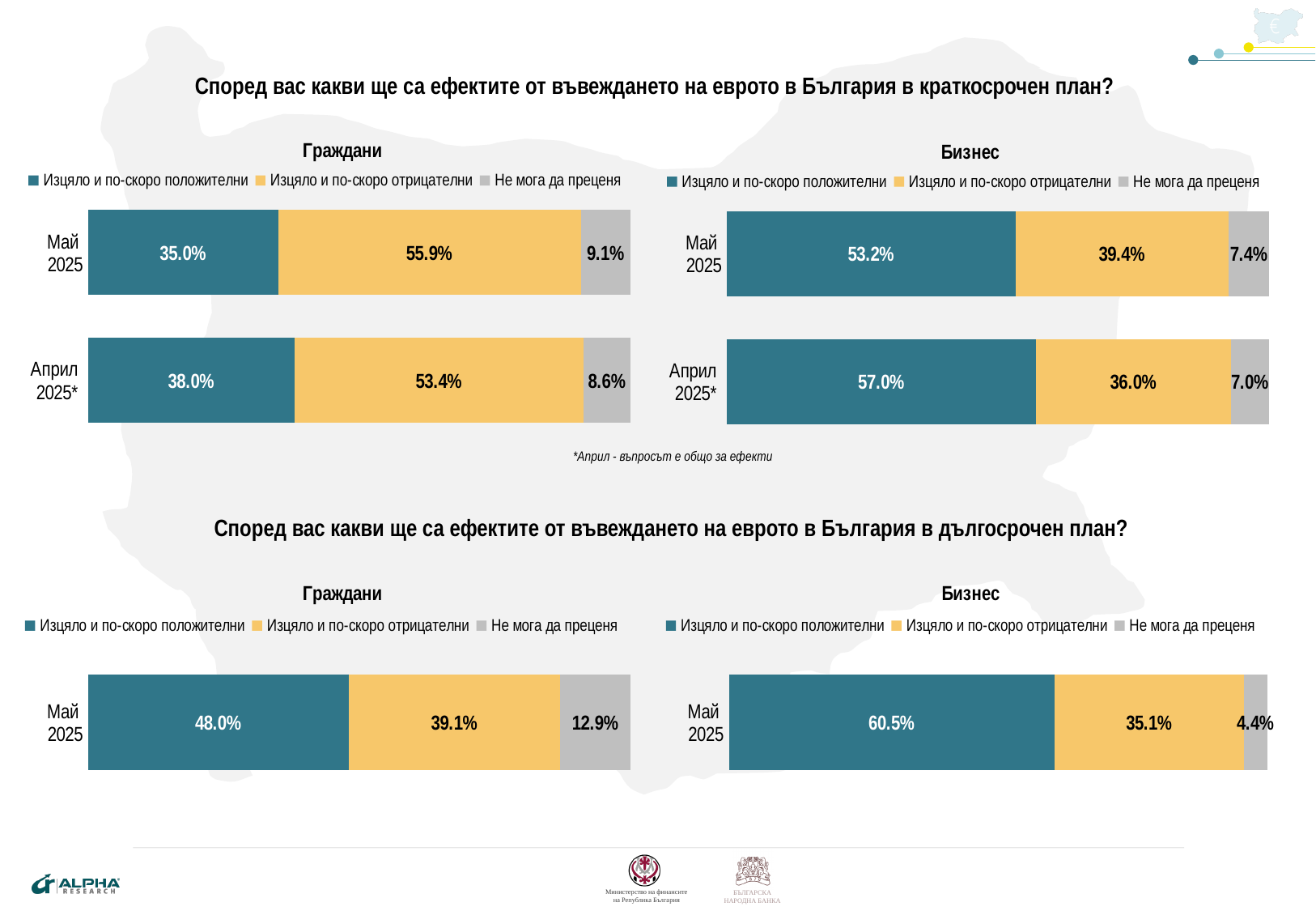
In the long-term (дългосрочен план) chart for Бизнес, what share of respondents in Май 2025 answered 'Изцяло и по-скоро положителни'? 60.5% In the long-term (дългосрочен план) chart for Бизнес, which response category has the smallest share in Май 2025? Не мога да преценя In the short-term (краткосрочен план) chart for Граждани, what share of respondents in Май 2025 answered 'Изцяло и по-скоро положителни'? 35.0% In the short-term (краткосрочен план) chart for Граждани, what is the difference between the 'Изцяло и по-скоро отрицателни' shares for Май 2025 and Април 2025*? 2.5% In the short-term (краткосрочен план) chart for Граждани, which response category has the largest share in Май 2025? Изцяло и по-скоро отрицателни What kind of chart is the long-term (дългосрочен план) chart for Граждани? Stacked bar chart How many series does the legend list in the short-term (краткосрочен план) chart for Граждани? 3 In the short-term (краткосрочен план) chart for Бизнес, what share of respondents in Април 2025* answered 'Изцяло и по-скоро отрицателни'? 36.0% In the short-term (краткосрочен план) chart for Бизнес, which period has the larger 'Изцяло и по-скоро положителни' share, Май 2025 or Април 2025*? Април 2025* How many periods (bars) are shown in the short-term (краткосрочен план) chart for Бизнес? 2 In the short-term (краткосрочен план) chart for Бизнес, what is the difference between the 'Не мога да преценя' shares for Май 2025 and Април 2025*? 0.4% In the long-term (дългосрочен план) chart for Граждани, what share of respondents in Май 2025 answered 'Не мога да преценя'? 12.9%